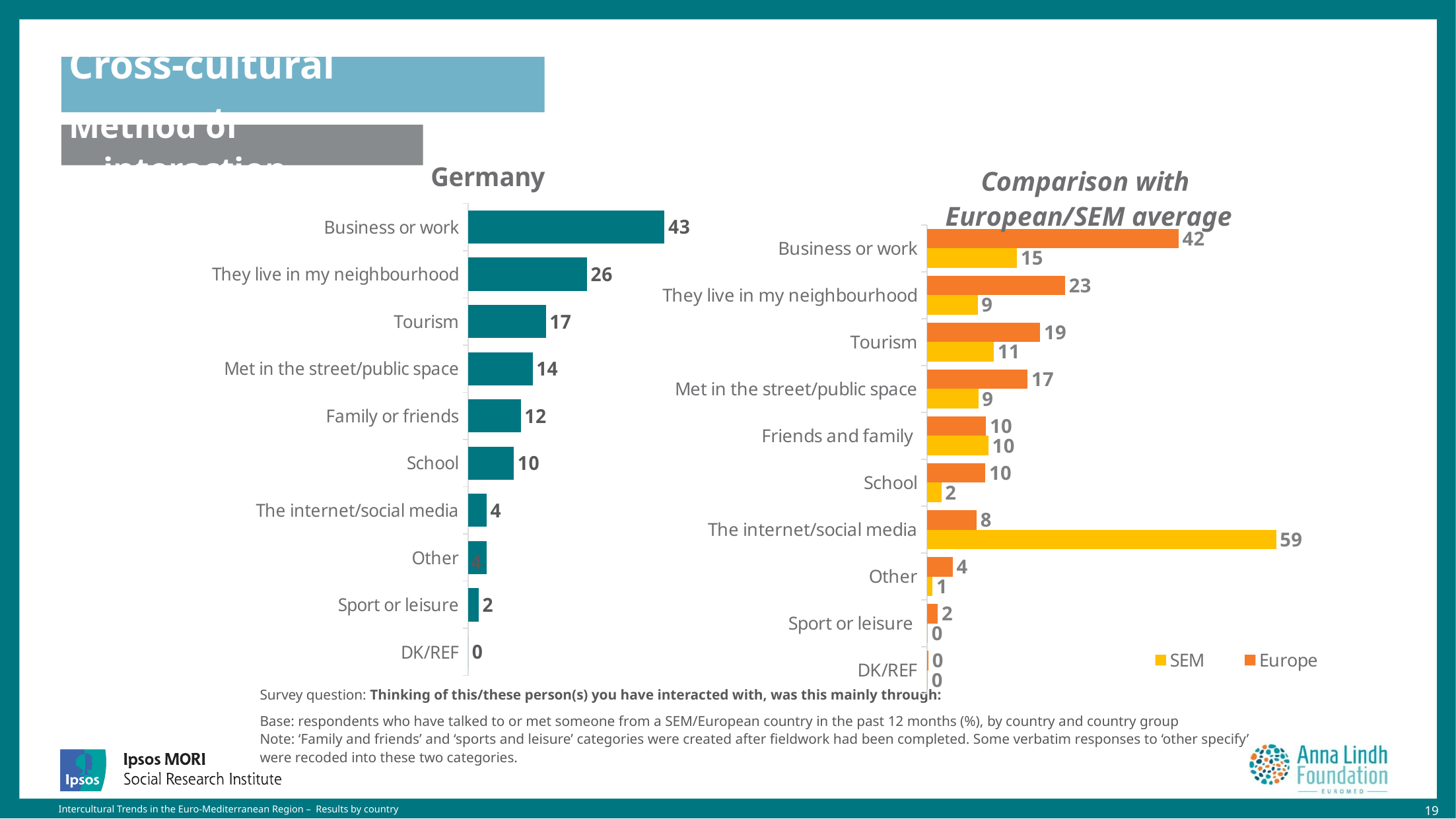
What type of chart is the Germany chart? Bar chart In the Germany chart, how many categories are shown? 10 In the Germany chart, what is the value for Business or work? 43 In the Comparison with European/SEM average chart, what is the Europe value for Business or work? 42 In the Comparison with European/SEM average chart, which is larger for Tourism, the Europe value or the SEM value? Europe In the Comparison with European/SEM average chart, how many series does the legend list? 2 In the Germany chart, what is the value for Sport or leisure? 2 In the Germany chart, which category has the highest value? Business or work In the Comparison with European/SEM average chart, what is the difference between the Europe and SEM values for School? 8 In the Comparison with European/SEM average chart, what is the SEM value for The internet/social media? 59 In the Comparison with European/SEM average chart, which colour represents the SEM series? Yellow In the Germany chart, what is the difference between They live in my neighbourhood and Tourism? 9